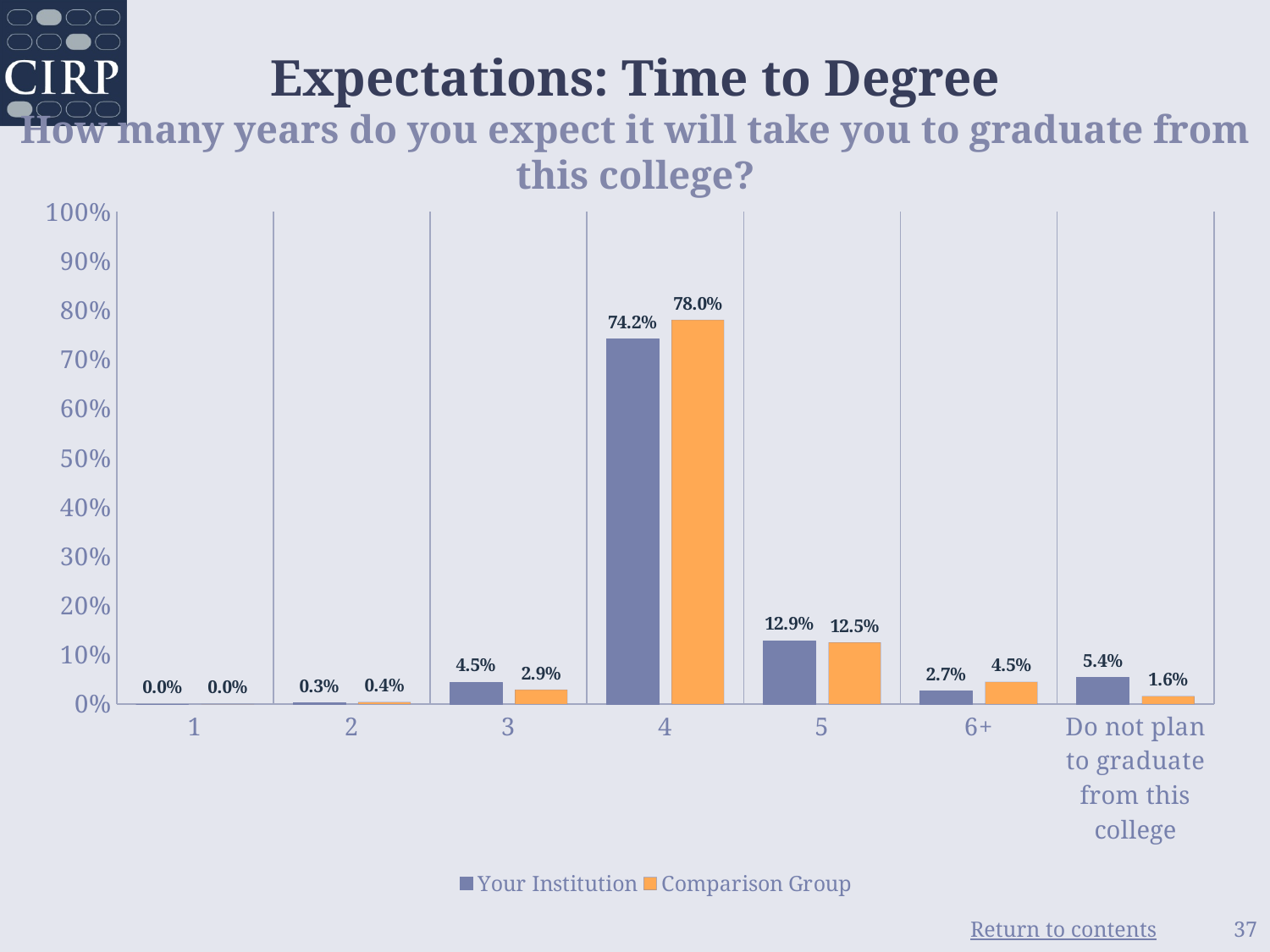
Which is larger in the 6+ category, Your Institution or Comparison Group? Comparison Group Which category has the lowest value for Your Institution? 1 What is the value for Comparison Group in the 5 category? 12.5% What is the value for Your Institution in the 4 category? 74.2% How many categories are shown on the x axis? 7 What is the value for Your Institution in the 'Do not plan to graduate from this college' category? 5.4% What colour are the Comparison Group bars? orange What is the difference between Comparison Group and Your Institution in the 4 category? 3.8% Which category has the highest value for Comparison Group? 4 How many series does the legend list? 2 Is the value for Your Institution in the 4 category greater or less than 70%? greater What kind of chart is shown on the slide? bar chart